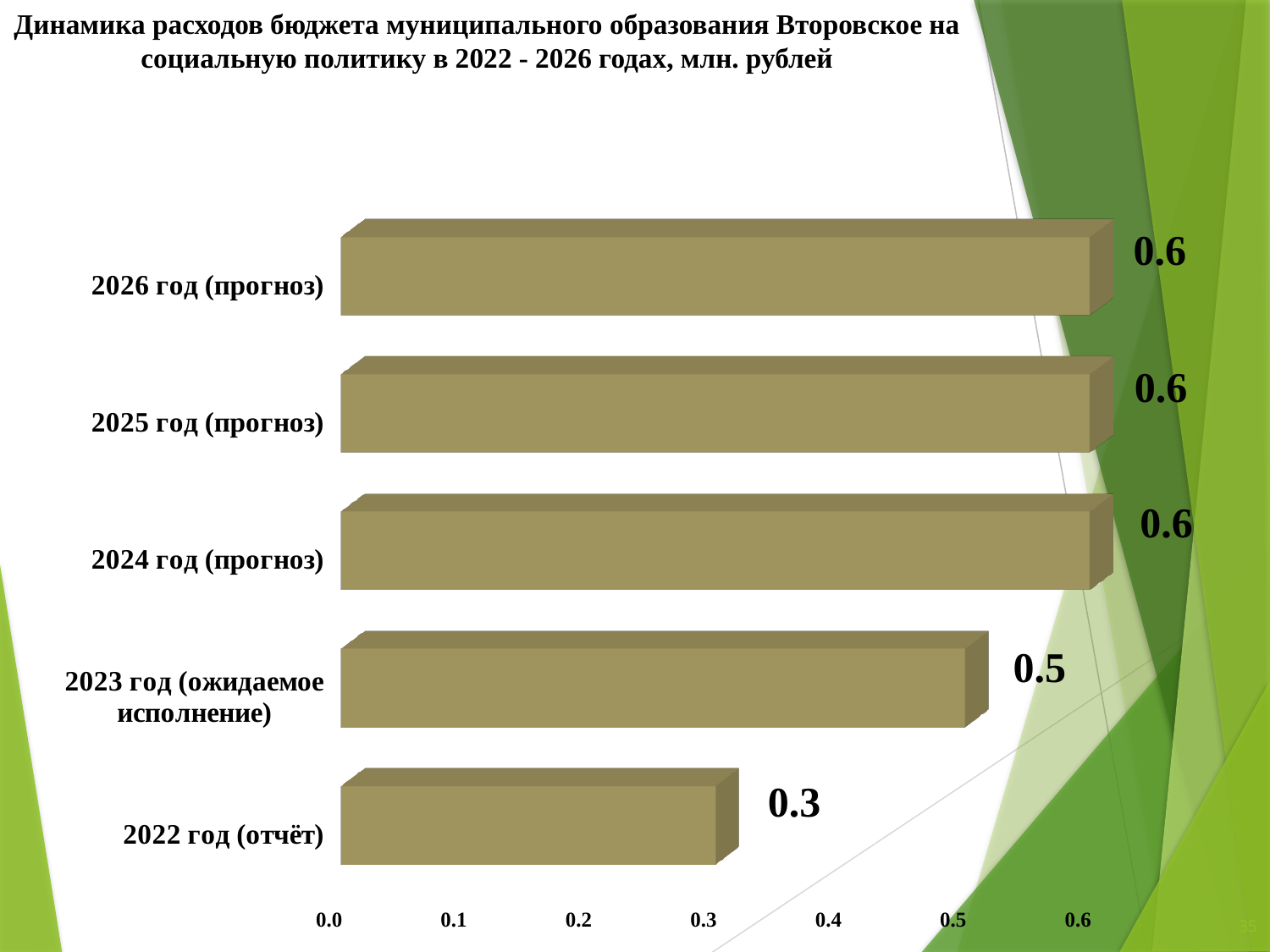
Is the value for 2022 год (отчёт) greater or less than 0.4? less Which is larger, the value for 2023 год (ожидаемое исполнение) or the value for 2022 год (отчёт)? 2023 год (ожидаемое исполнение) What is the value for 2023 год (ожидаемое исполнение)? 0.5 What is the difference between the values for 2024 год (прогноз) and 2022 год (отчёт)? 0.3 What kind of chart is shown on the slide? bar chart How many categories are shown in the chart? 5 What is the value for 2024 год (прогноз)? 0.6 What is the value for 2026 год (прогноз)? 0.6 What is the difference between the values for 2023 год (ожидаемое исполнение) and 2022 год (отчёт)? 0.2 What is the value for 2022 год (отчёт)? 0.3 Do the values rise or fall from 2022 to 2026? rise Which category has the lowest value? 2022 год (отчёт)